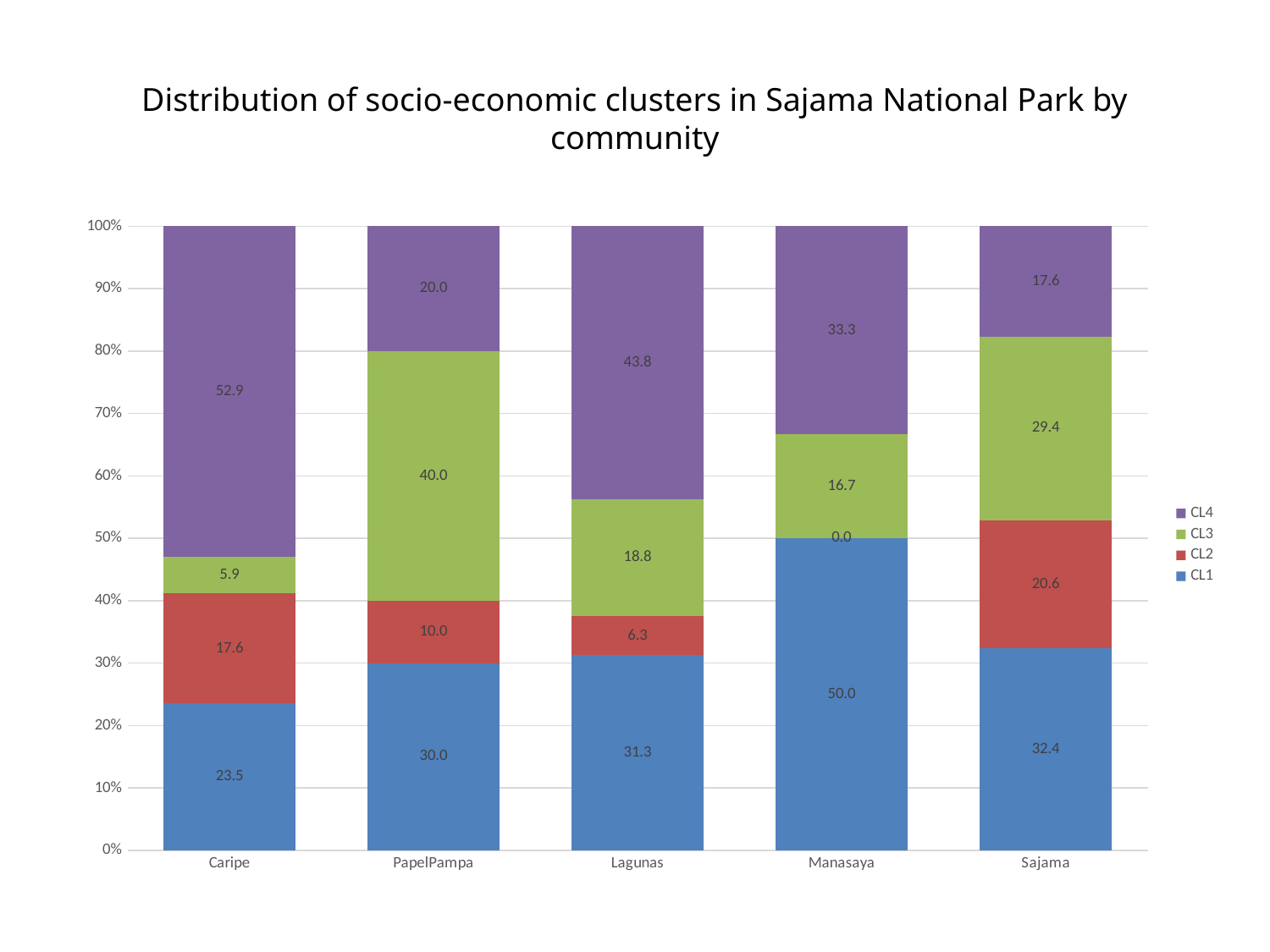
What is the difference between the CL4 values for Lagunas and PapelPampa? 23.8 What is the CL3 value for PapelPampa? 40.0 What kind of chart is shown on the slide? Stacked bar chart How many communities are shown on the x axis? 5 What is the CL1 value for Sajama? 32.4 Which community has the lowest CL4 value? Sajama Which community has the highest CL1 value? Manasaya Which is larger, the CL2 value for Caripe or the CL2 value for Lagunas? Caripe What is the CL4 value for Caripe? 52.9 How many series does the legend list? 4 What is the CL2 value for Manasaya? 0.0 What is the title of the chart? Distribution of socio-economic clusters in Sajama National Park by community